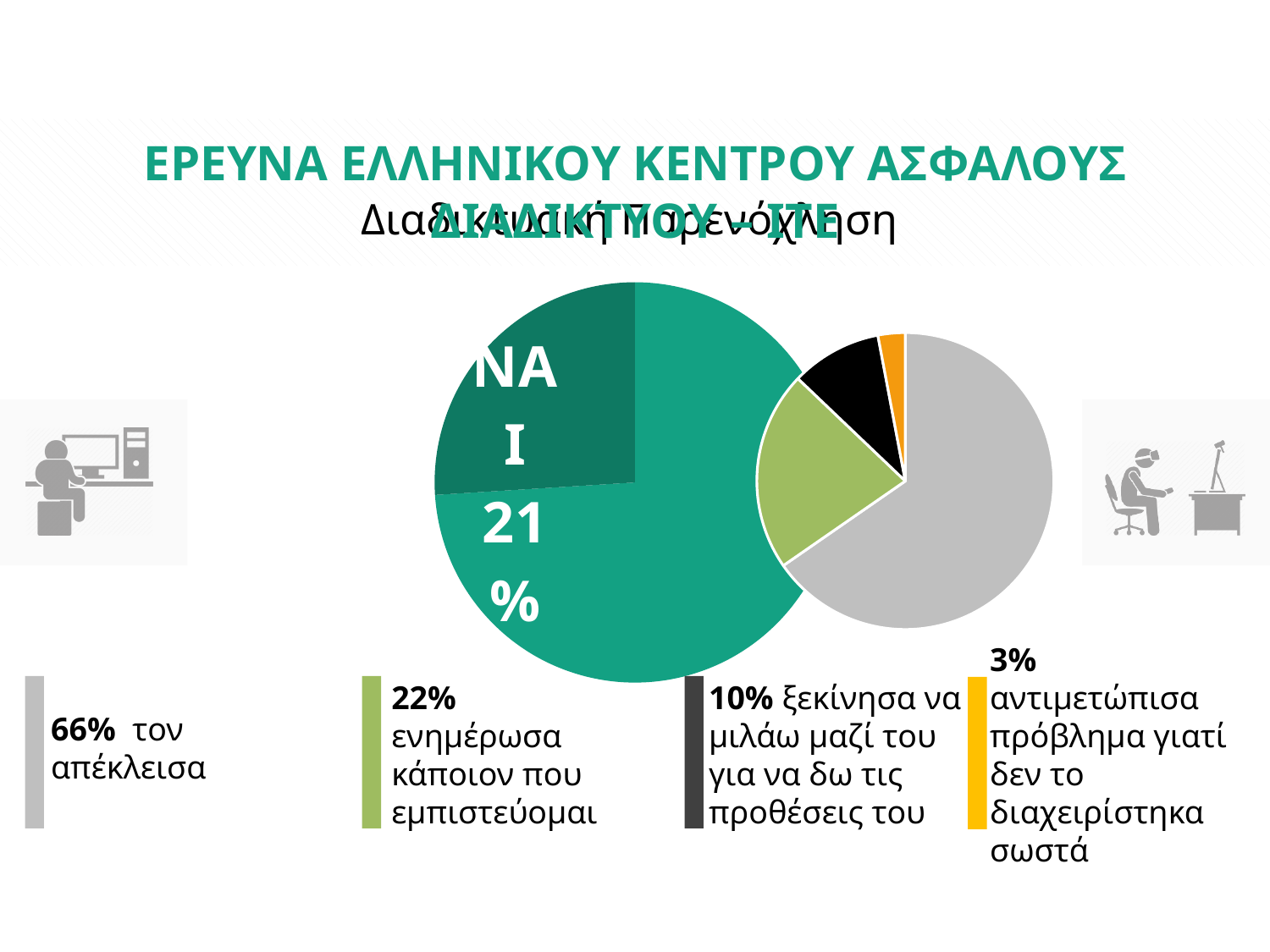
In the smaller pie chart on the right, which response has the largest share? τον απέκλεισα What kind of chart is the large chart on the left of the slide? pie chart In the smaller pie chart on the right, what percentage corresponds to 'ξεκίνησα να μιλάω μαζί του για να δω τις προθέσεις του'? 10% In the large pie chart on the left, what percentage is shown for the slice labelled ΝΑΙ? 21% In the smaller pie chart on the right, what colour is the slice for 'τον απέκλεισα'? grey In the smaller pie chart on the right, which response has the smallest share? αντιμετώπισα πρόβλημα γιατί δεν το διαχειρίστηκα σωστά In the smaller pie chart on the right, what is the difference in percentage points between 'τον απέκλεισα' and 'ενημέρωσα κάποιον που εμπιστεύομαι'? 44 In the smaller pie chart on the right, what percentage corresponds to 'τον απέκλεισα'? 66% In the smaller pie chart on the right, what percentage corresponds to 'ενημέρωσα κάποιον που εμπιστεύομαι'? 22% In the smaller pie chart on the right, what percentage corresponds to 'αντιμετώπισα πρόβλημα γιατί δεν το διαχειρίστηκα σωστά'? 3% In the smaller pie chart on the right, how many slices are there? 4 In the smaller pie chart on the right, which is larger: 'ενημέρωσα κάποιον που εμπιστεύομαι' or 'ξεκίνησα να μιλάω μαζί του'? ενημέρωσα κάποιον που εμπιστεύομαι